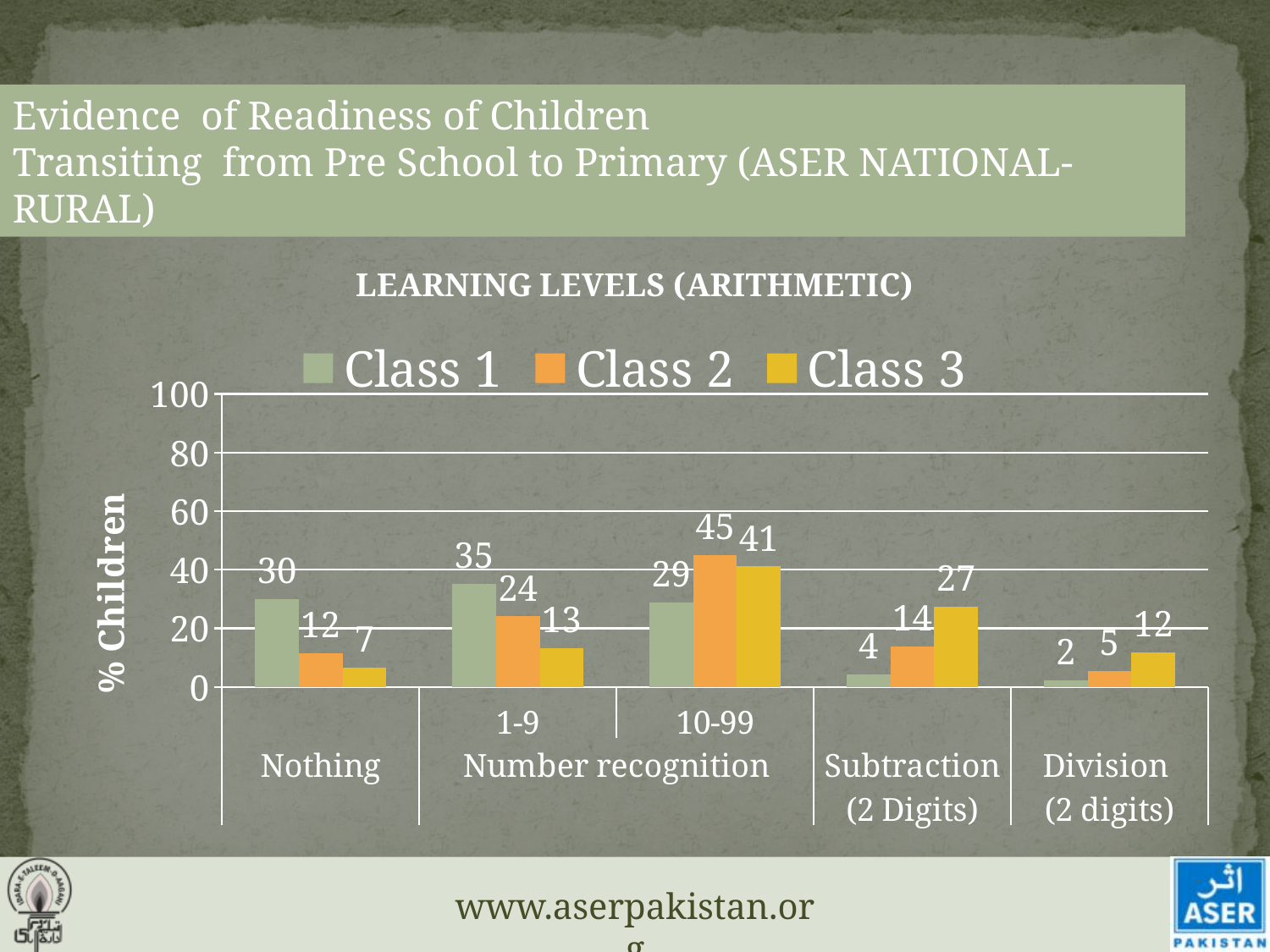
How many series does the legend list? 3 Which is larger for Subtraction (2 Digits): the Class 2 value or the Class 3 value? Class 3 What is the Class 1 value for Nothing? 30 What is the y-axis label of the chart? % Children What kind of chart is shown? Bar chart Which category has the lowest Class 3 value? Nothing What is the Class 2 value for Number recognition 10-99? 45 What is the Class 3 value for Subtraction (2 Digits)? 27 Which category has the highest Class 1 value? Number recognition 1-9 What is the difference between the Class 2 and Class 3 values for Number recognition 10-99? 4 What is the Class 1 value for Division (2 digits)? 2 How many categories are shown on the x axis? 5